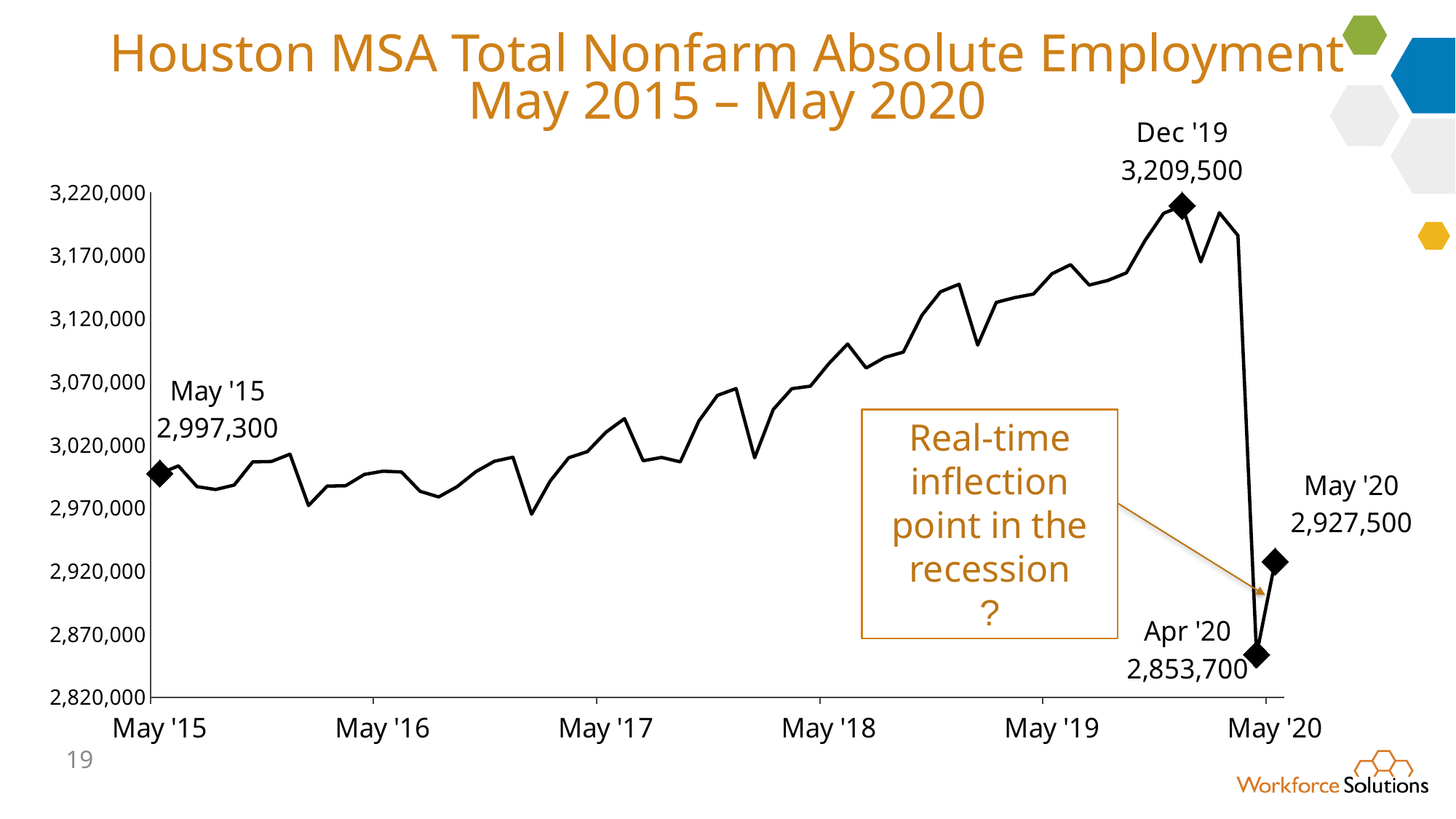
What was the employment value labeled for Dec '19? 3,209,500 By how much did employment increase from Apr '20 to May '20? 73,800 What is the difference between the Dec '19 and Apr '20 employment values? 355,800 What was the employment value labeled for May '20? 2,927,500 Is the employment value for May '19 greater or less than 3,120,000? greater Which labeled month has the highest employment value? Dec '19 Which is larger, the employment value for May '15 or for May '20? May '15 What was the employment value labeled for Apr '20? 2,853,700 What was Houston MSA total nonfarm employment in May '15? 2,997,300 Does employment generally rise or fall from May '15 to Dec '19? rise Which labeled month has the lowest employment value? Apr '20 What kind of chart is shown on the slide? line chart